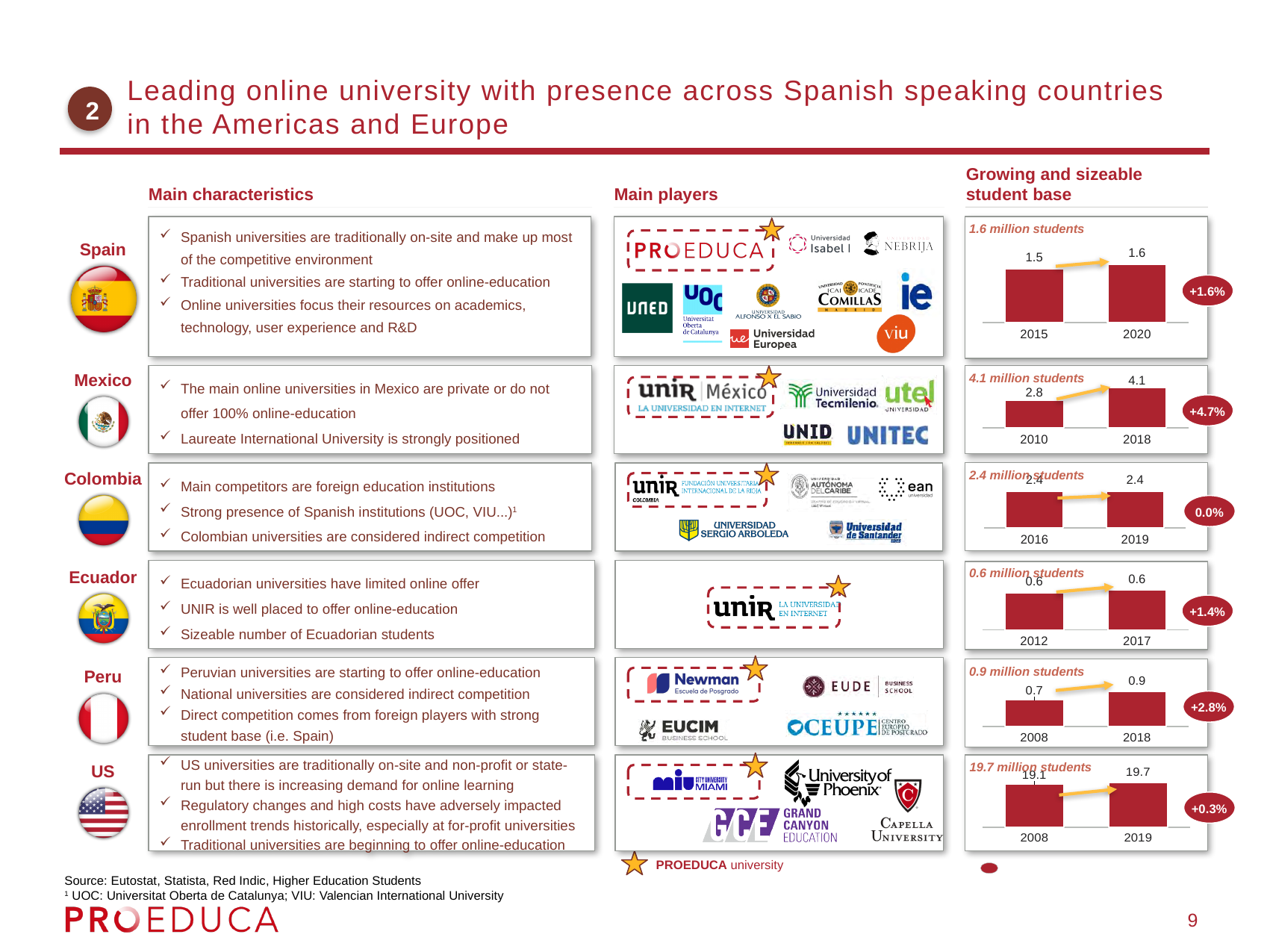
What growth rate is shown next to the Mexico student base chart? +4.7% In the Colombia student base chart, what is the value for 2016? 2.4 In the US student base chart, what is the difference between the 2019 and 2008 values? 0.6 In the Spain student base chart, what is the value for 2015? 1.5 In the Mexico student base chart, which year has the higher value, 2010 or 2018? 2018 In the Peru student base chart, do the values rise or fall from 2008 to 2018? rise In the Mexico student base chart, what is the difference between the 2018 and 2010 values? 1.3 In the Peru student base chart, what is the value for 2008? 0.7 What kind of chart is used to show the student base for each country? bar chart In the US student base chart, what is the value for 2019? 19.7 In the Mexico student base chart, what is the value for 2018? 4.1 How many bars are in the Ecuador student base chart? 2